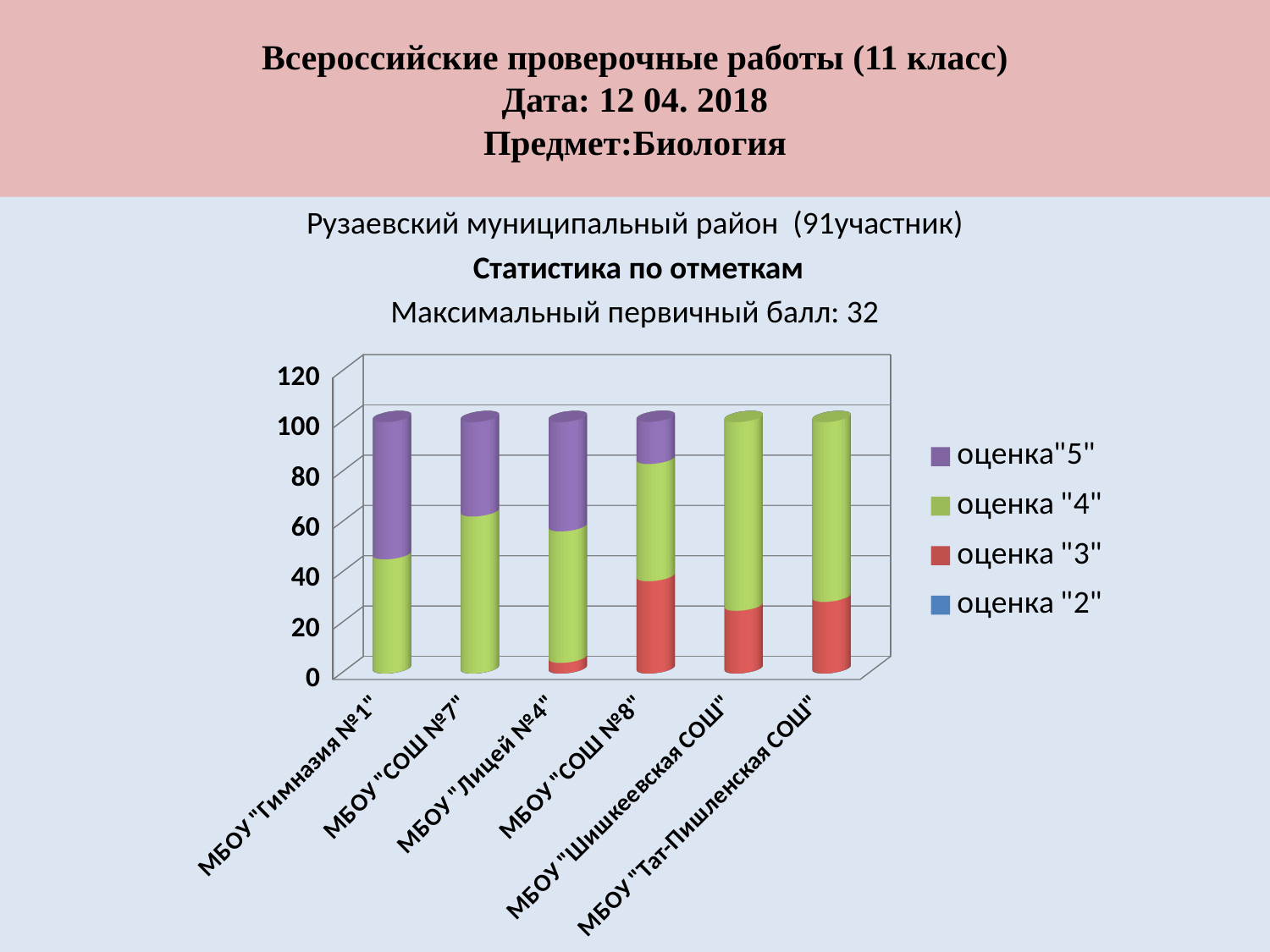
Which is larger, the оценка "3" value for МБОУ "СОШ №8" or for МБОУ "Лицей №4"? МБОУ "СОШ №8" Which colour represents оценка "5" in the chart legend? purple What is the title of the chart? Статистика по отметкам Is the value of оценка "4" for МБОУ "Шишкеевская СОШ" greater or less than 60? greater Is the value of оценка "5" for МБОУ "Гимназия №1" greater or less than 40? greater What kind of chart is shown on the slide? stacked bar chart Is the value of оценка "3" for МБОУ "СОШ №8" greater or less than 20? greater How many series does the chart legend list? 4 Which school has the largest оценка "5" segment? МБОУ "Гимназия №1" How many schools have no оценка "5" segment in their bar? 2 How many schools (categories) are shown on the x axis of the chart? 6 What is the total height of the stacked bar for МБОУ "Гимназия №1"? 100